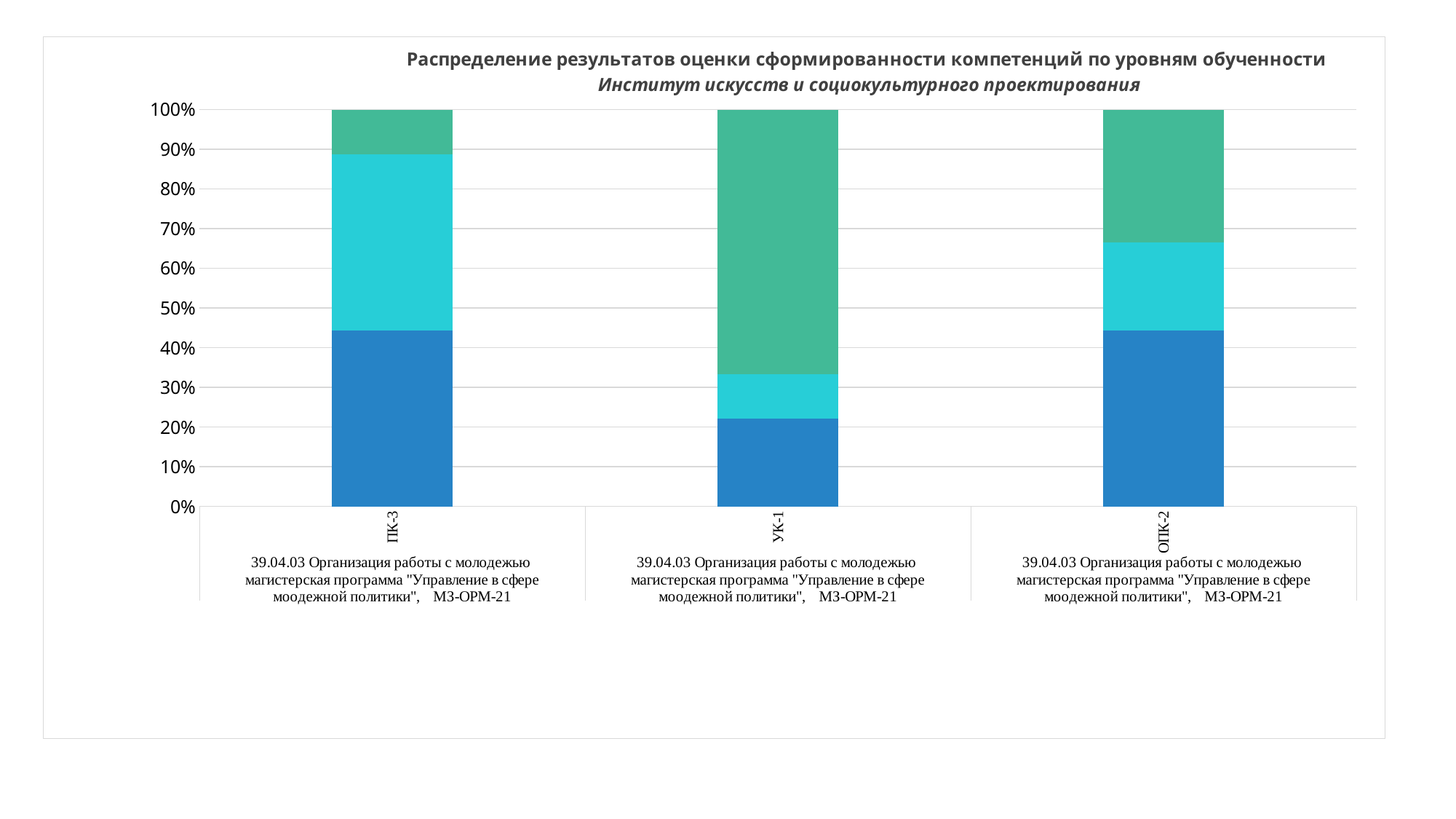
Which category has the smallest top (green) segment? ПК-3 Is the middle (cyan) segment for УК-1 greater or less than 20%? less Is the bottom (blue) segment for ОПК-2 greater or less than 40%? greater How many coloured segments make up each stacked bar? 3 Is the bottom (blue) segment for ПК-3 greater or less than 40%? greater What kind of chart is shown on the slide? Stacked bar chart Which category has the larger bottom (blue) segment, ПК-3 or УК-1? ПК-3 How many competency categories are plotted along the x axis? 3 Which institute is named in the chart's subtitle? Институт искусств и социокультурного проектирования What is the total height of the stacked bar for ПК-3? 100% Which category has the largest top (green) segment? УК-1